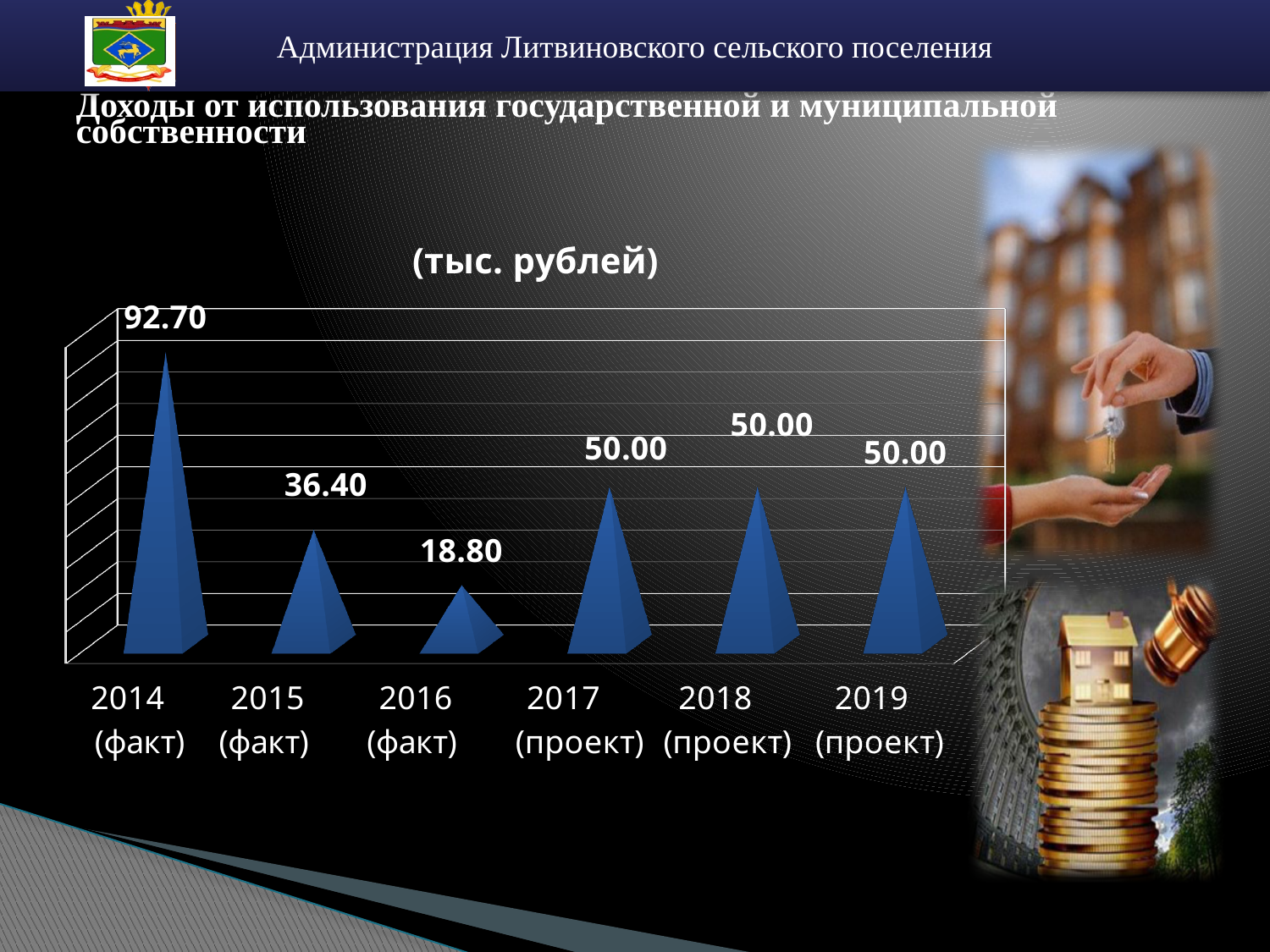
What is the value for 2014 (факт)? 92.70 What is the value for 2016 (факт)? 18.80 What is the difference between the values for 2017 (проект) and 2016 (факт)? 31.20 What is the difference between the values for 2014 (факт) and 2015 (факт)? 56.30 Which category has the lowest value? 2016 (факт) Which is larger, the value for 2015 (факт) or the value for 2017 (проект)? 2017 (проект) What unit is given in the chart title? тыс. рублей How many categories are shown on the x axis? 6 What kind of chart is shown on the slide? bar chart Do the values rise or fall from 2014 (факт) to 2016 (факт)? fall Which category has the highest value? 2014 (факт) What is the value for 2018 (проект)? 50.00